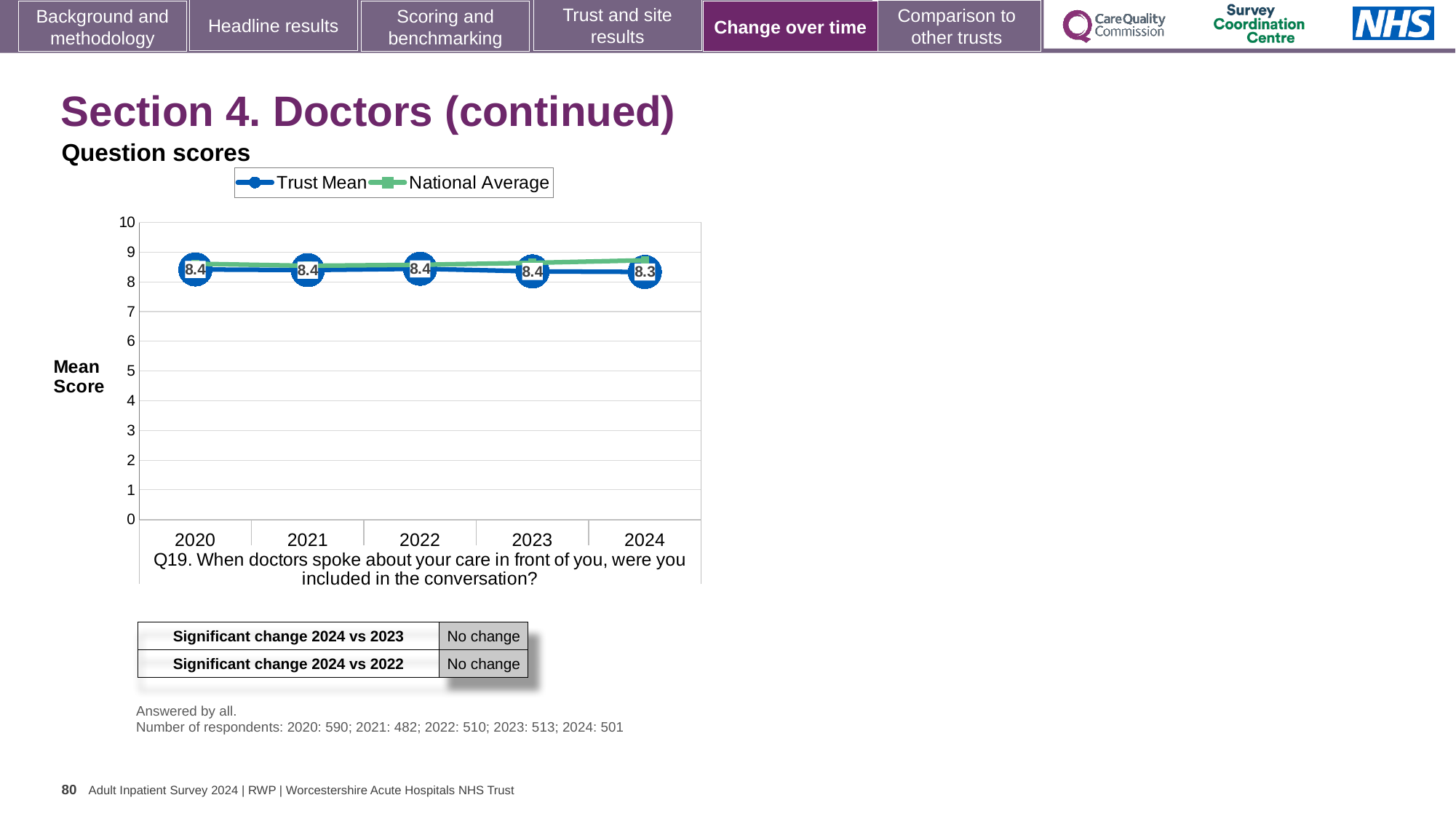
What is the Trust Mean score for 2024? 8.3 What is the Trust Mean score for 2020? 8.4 What is the label on the y axis of the chart? Mean Score Which is larger, the Trust Mean score for 2023 or for 2024? 2023 Which year has the lowest Trust Mean score? 2024 What kind of chart is shown? line chart What is the Trust Mean score for 2022? 8.4 What is the difference between the Trust Mean score in 2020 and in 2024? 0.1 How many series does the legend list? 2 How many years are plotted on the x axis? 5 Is the National Average value for 2024 greater or less than 8? greater Does the Trust Mean score rise or fall from 2023 to 2024? fall